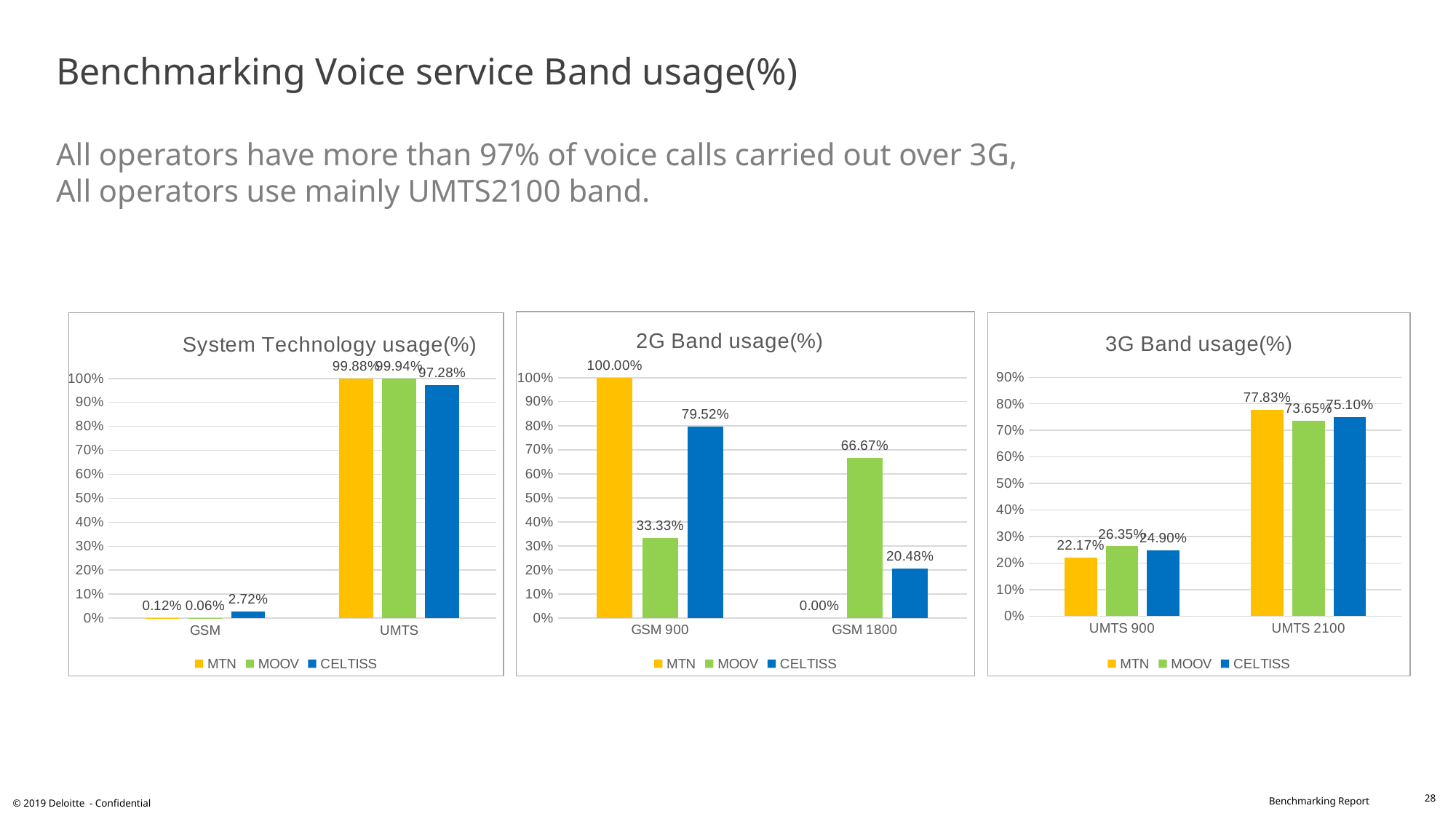
In the 2G Band usage(%) chart, is the value for CELTISS at GSM 900 greater or less than 70%? greater In the 2G Band usage(%) chart, what is the difference between CELTISS at GSM 900 and CELTISS at GSM 1800? 59.04% In the 2G Band usage(%) chart, what is the value for MOOV at GSM 1800? 66.67% In the 2G Band usage(%) chart, what is the value for MTN at GSM 900? 100.00% What kind of chart is the System Technology usage(%) chart? bar chart In the 3G Band usage(%) chart, which is larger: MTN at UMTS 2100 or MOOV at UMTS 2100? MTN at UMTS 2100 How many series does the legend of the 3G Band usage(%) chart list? 3 In the 3G Band usage(%) chart, which operator has the highest value at UMTS 900? MOOV In the 3G Band usage(%) chart, what is the value for CELTISS at UMTS 2100? 75.10% In the 3G Band usage(%) chart, what is the total of the MTN values across UMTS 900 and UMTS 2100? 100.00% In the System Technology usage(%) chart, what is the value for CELTISS at GSM? 2.72% In the 2G Band usage(%) chart, which operator has the lowest value at GSM 900? MOOV